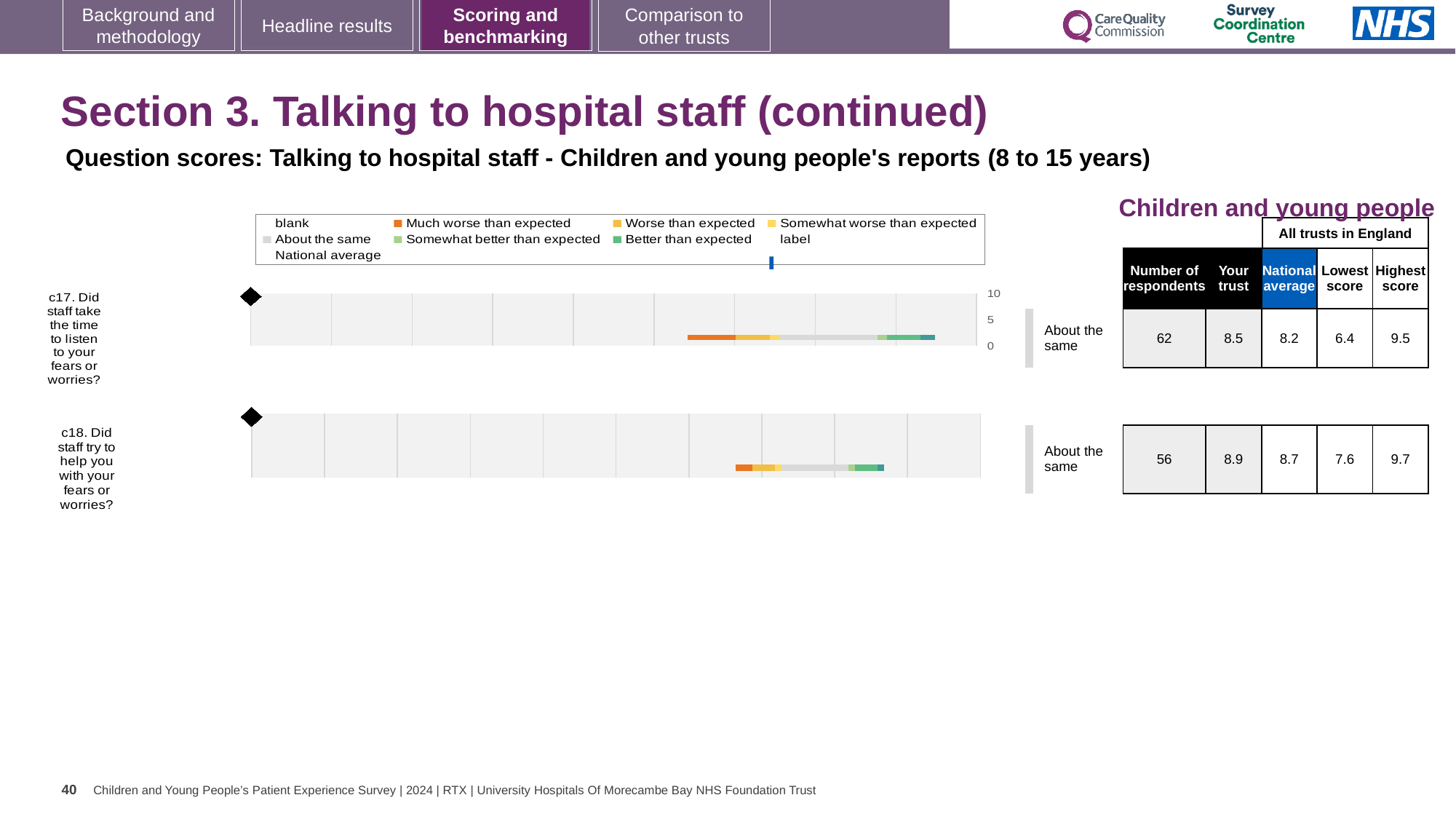
What is the lowest score across all trusts in England for c18? 7.6 Which legend entry is shown in orange? Much worse than expected What kind of chart is used to show the question scores for c17 and c18? bar chart What is the 'Your trust' score for c17 (Did staff take the time to listen to your fears or worries?)? 8.5 What is the difference between the highest and lowest scores across all trusts in England for c17? 3.1 How many respondents answered question c17? 62 What is the national average score for c18 (Did staff try to help you with your fears or worries?)? 8.7 Which question has the higher 'Your trust' score, c17 or c18? c18 What is the difference between the 'Your trust' score and the national average for c18? 0.2 What benchmark category is shown next to the c17 chart? About the same How many survey questions are plotted on the slide? 2 Which question has the higher 'Highest score' across all trusts in England? c18